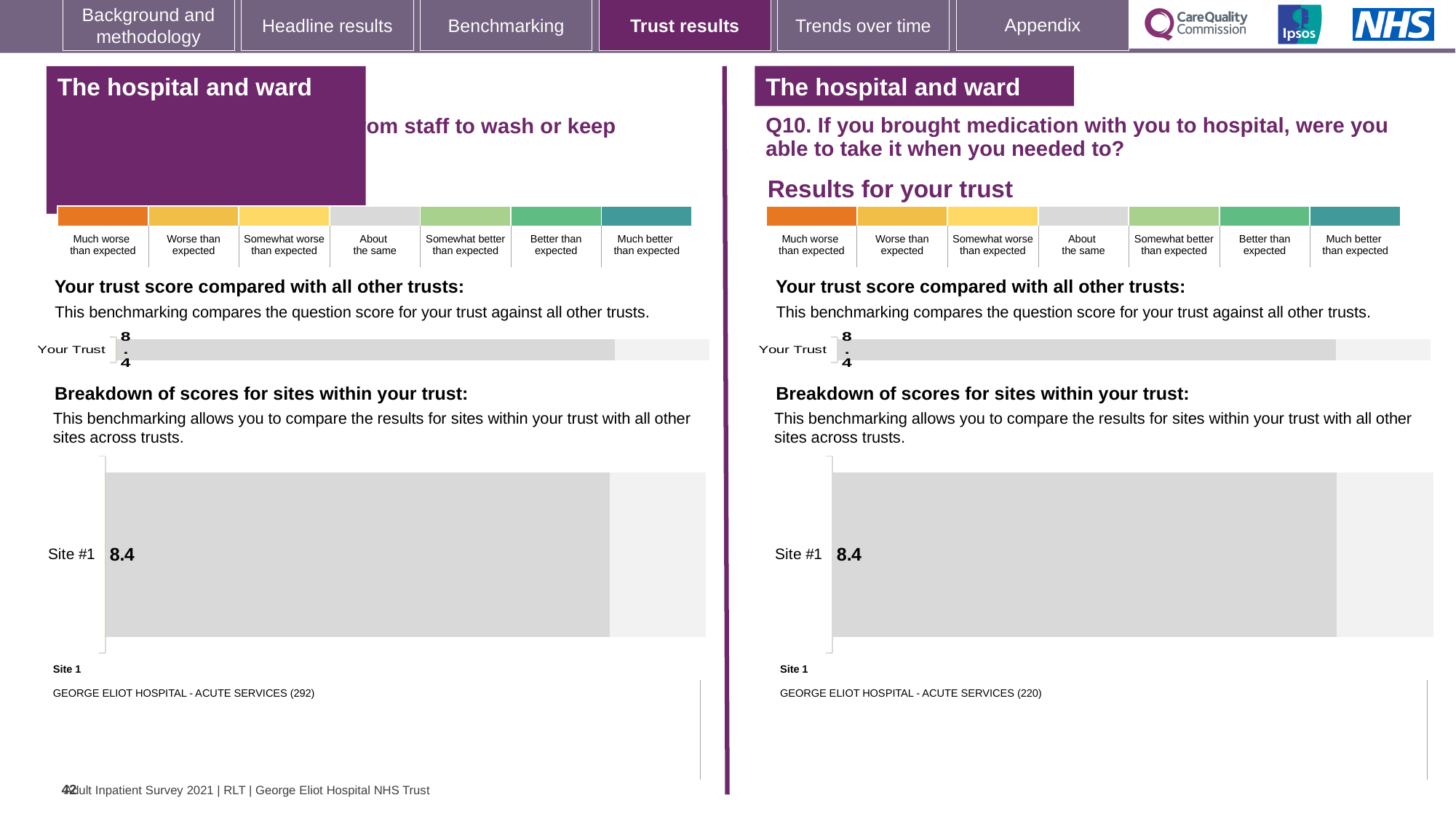
On the left half of the slide, what is the score shown for Your Trust in the 'Your trust score compared with all other trusts' chart? 8.4 On the right half of the slide (Q10), which hospital site is listed as Site 1 below the breakdown chart? GEORGE ELIOT HOSPITAL - ACUTE SERVICES (220) How many sites are plotted in the 'Breakdown of scores for sites within your trust' chart on the right half of the slide (Q10)? 1 How many sites are plotted in the 'Breakdown of scores for sites within your trust' chart on the left half of the slide? 1 On the right half of the slide (Q10), what is the score shown for Your Trust in the 'Your trust score compared with all other trusts' chart? 8.4 On the left half of the slide, what score is shown for Site #1 in the 'Breakdown of scores for sites within your trust' chart? 8.4 On the right half of the slide (Q10), what score is shown for Site #1 in the 'Breakdown of scores for sites within your trust' chart? 8.4 On the right half of the slide (Q10), is the Your Trust score larger than, smaller than, or equal to the Site #1 score? equal How many rating categories, from 'Much worse than expected' to 'Much better than expected', are shown in the colour scale above the charts on the right half of the slide? 7 What kind of chart is the 'Breakdown of scores for sites within your trust' chart on the right half of the slide (Q10)? bar chart